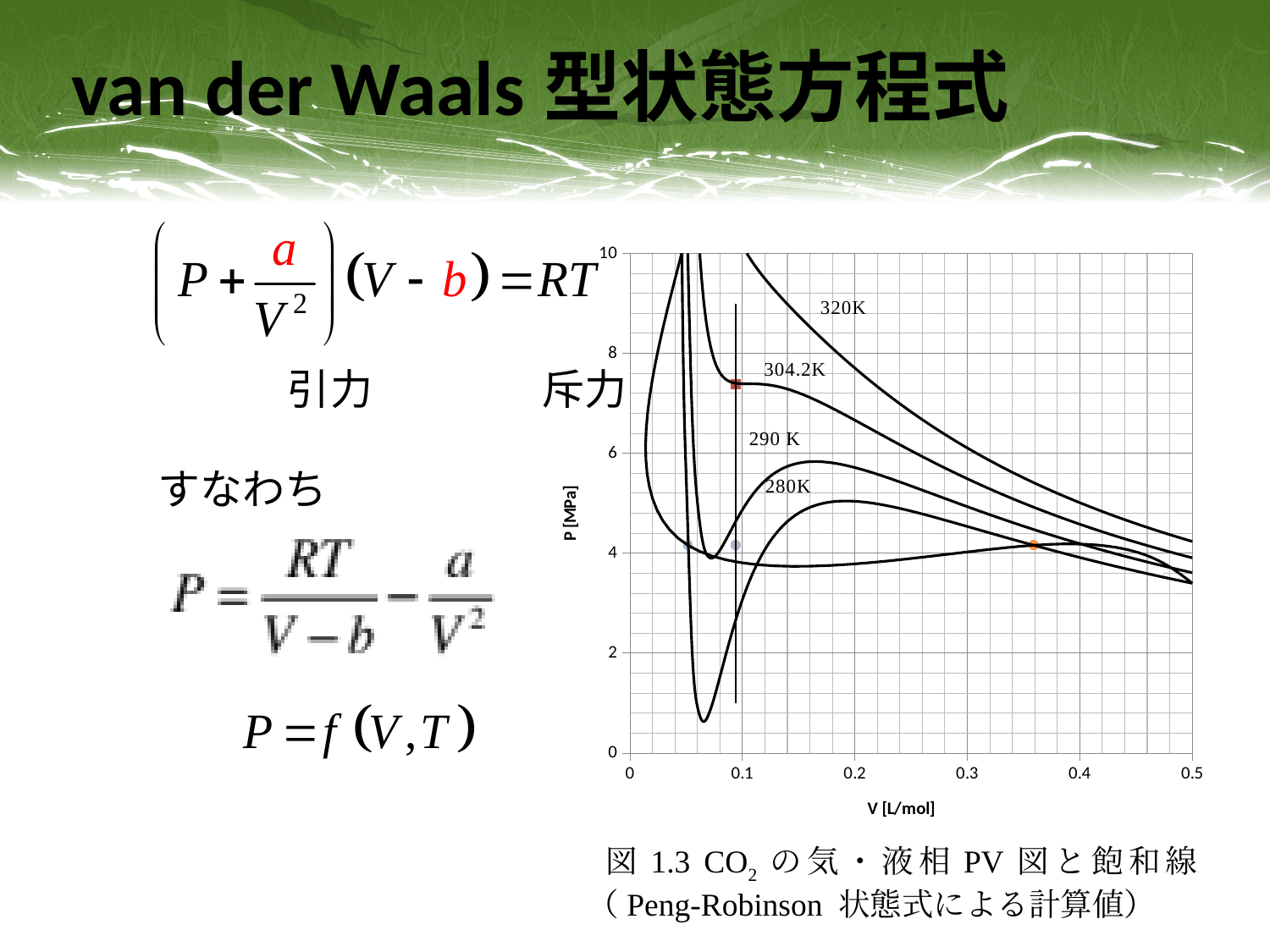
At V = 0.5 L/mol, is the pressure on the 320K isotherm greater or less than 6 MPa? less What is the maximum value shown on the vertical P axis of the chart? 10 Along the 320K isotherm, does the pressure rise or fall as V increases? fall According to the figure caption, which equation of state was used to calculate the curves? Peng-Robinson How many temperature-labelled isotherms are drawn on the PV chart? 4 What is the maximum value shown on the horizontal V axis of the chart? 0.5 Which labelled isotherm on the chart has the highest temperature? 320K Is the minimum pressure reached by the 280K isotherm greater or less than 2 MPa? less What quantity and unit are labelled on the vertical axis of the chart? P [MPa] Which labelled isotherm on the chart has the lowest temperature? 280K What kind of chart is shown on the slide? line chart At V = 0.3 L/mol, which isotherm shows the higher pressure, 320K or 280K? 320K